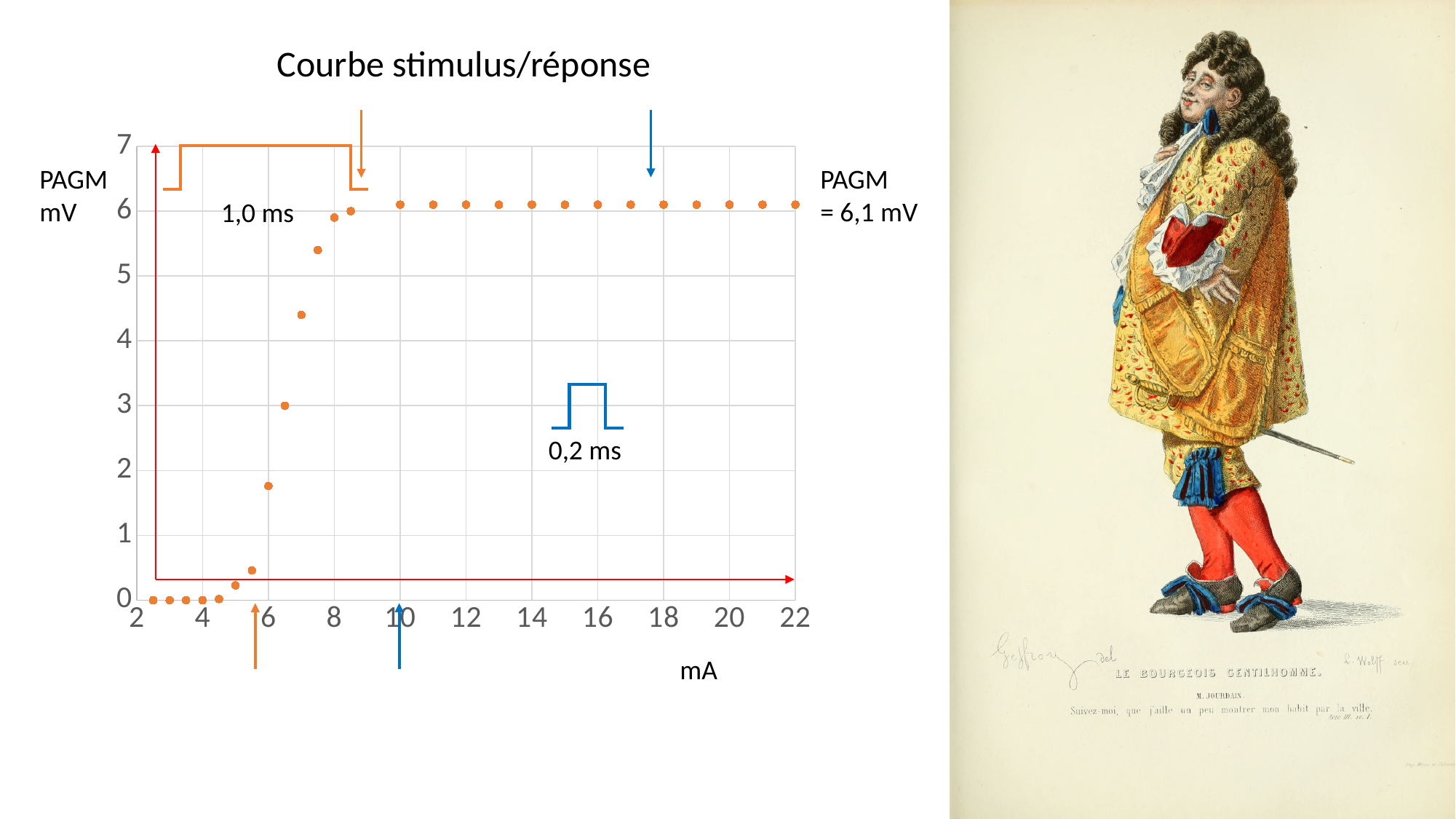
What unit is shown on the x axis of the chart? mA What is the title of the chart? Courbe stimulus/réponse Which has the larger PAGM value, 6 mA or 7 mA? 7 mA What is the PAGM value reached on the plateau of the curve, as annotated on the chart? 6,1 mV Is the PAGM value at 7 mA greater or less than 4? greater Is the PAGM value at 6 mA greater or less than 2? less Is the PAGM value at 20 mA greater or less than 6? greater What is the PAGM value at 4 mA? 0 What is the PAGM value at 6,5 mA? 3 What kind of chart is shown on the slide? scatter chart